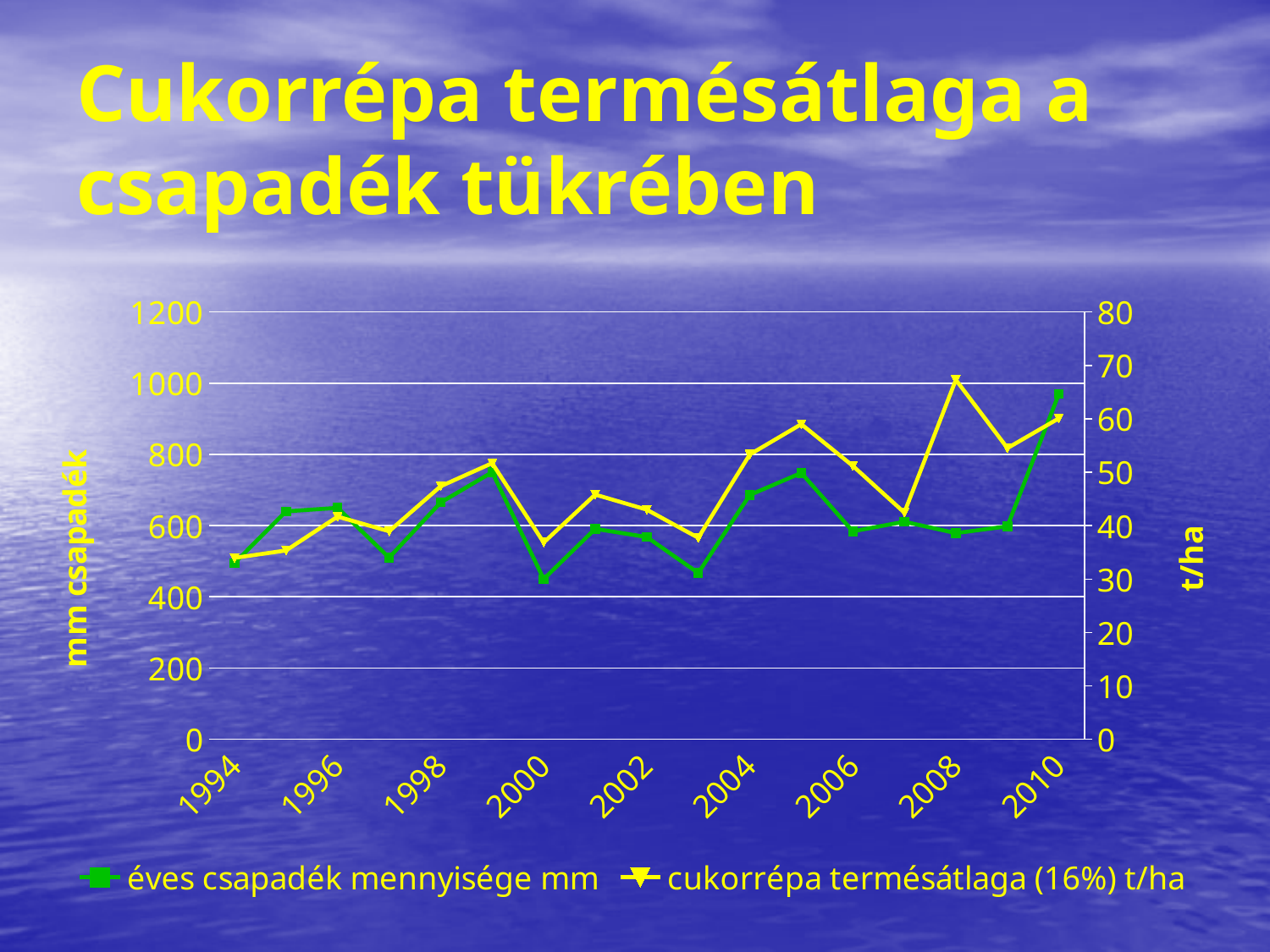
Does the annual precipitation rise or fall from 2009 to 2010? rise What kind of chart is shown on the slide? line chart Is the annual precipitation value for 2010 greater or less than 800? greater In which year is the sugar beet yield (cukorrépa termésátlaga) highest? 2008 Is the annual precipitation value for 2000 greater or less than 600? less Which year has the larger sugar beet yield, 2003 or 2005? 2005 Is the sugar beet yield value for 2008 greater or less than 60? greater What is the label of the right-hand vertical axis? t/ha How many series does the legend list? 2 Which series is drawn in green? éves csapadék mennyisége mm In which year is the annual precipitation (éves csapadék mennyisége mm) highest? 2010